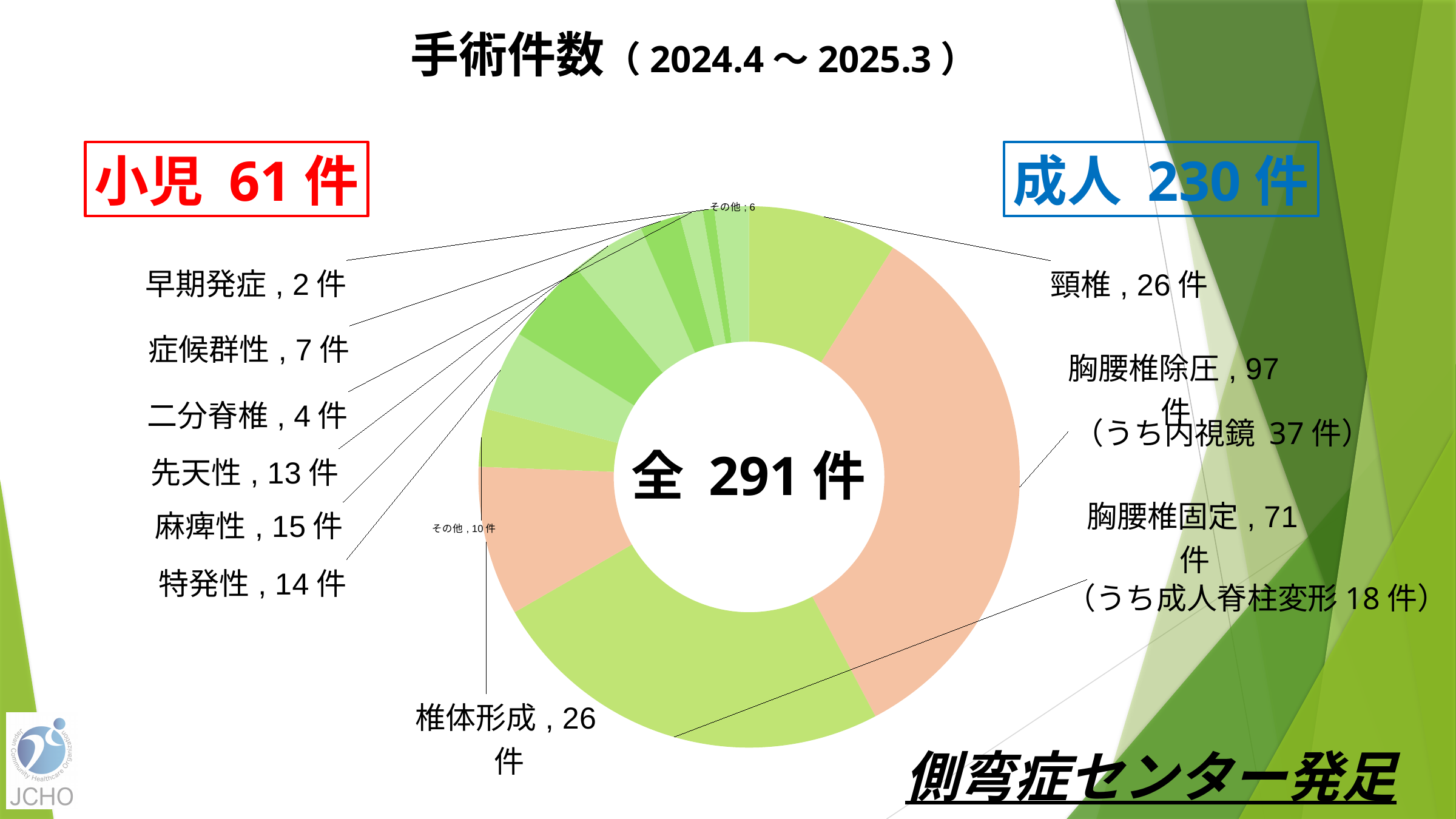
What is the value for 胸腰椎除圧 in the donut chart? 97件 What is the total number of cases shown in the centre of the chart? 全 291件 What is the total for the 小児 (pediatric) group shown on the slide? 61件 What kind of chart is shown on the slide? Donut (pie) chart Which is larger, 先天性 or 症候群性? 先天性 What is the difference between 胸腰椎除圧 and 胸腰椎固定? 26件 How many cases are shown for 麻痺性 in the chart? 15件 Which category has the largest value in the chart? 胸腰椎除圧 What is the period given in the chart title? 2024.4～2025.3 What is the difference between 麻痺性 and 特発性? 1件 Which category has the smallest value in the chart? 早期発症 What is the value labelled for 頸椎 in the chart? 26件